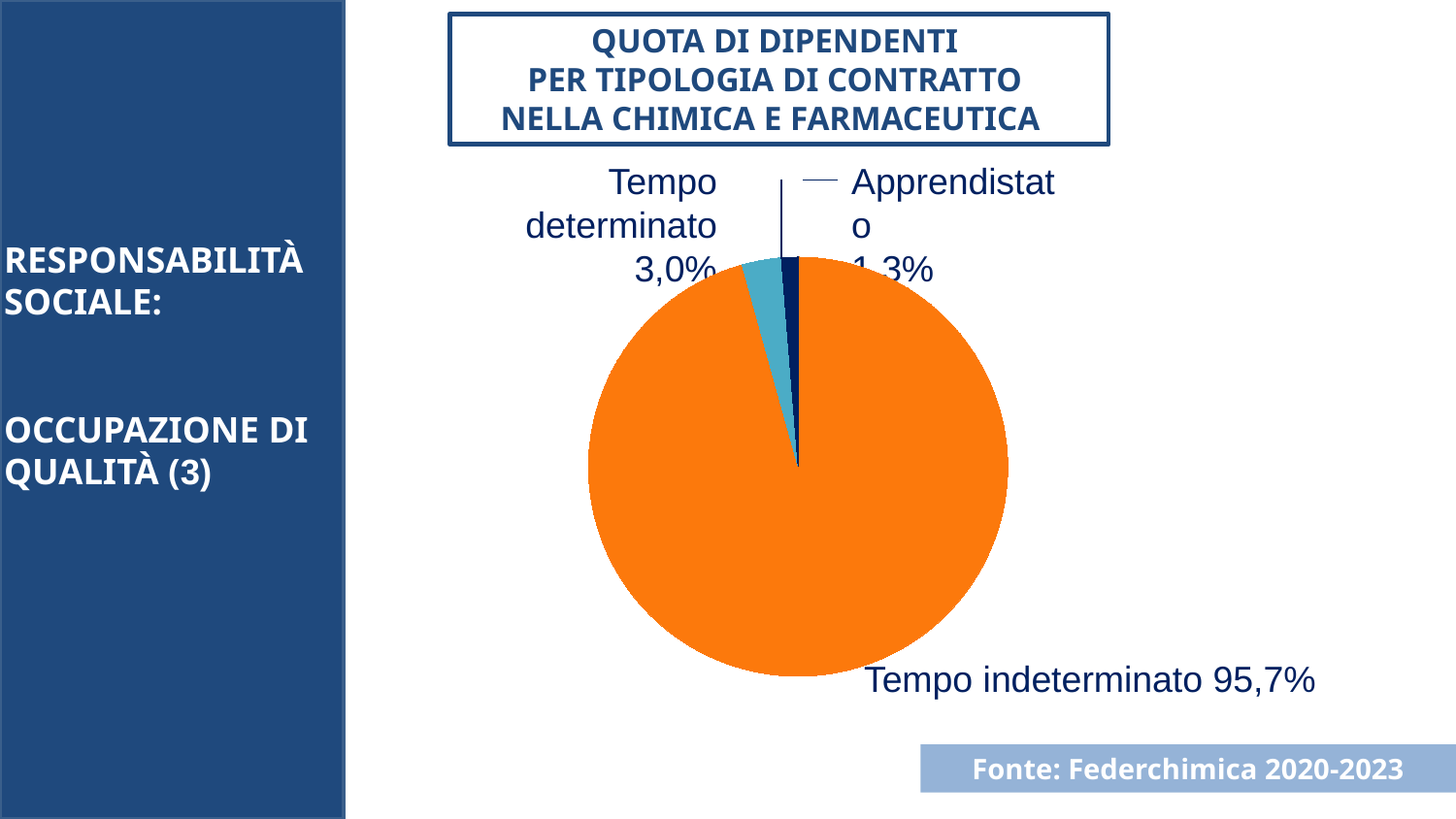
What share of employees have a 'Tempo determinato' contract? 3,0% What kind of chart is shown on the slide? Pie chart What is the difference in percentage points between the 'Tempo determinato' and 'Apprendistato' shares? 1,7 What share of employees have an 'Apprendistato' contract? 1,3% Which contract type has the largest share of employees? Tempo indeterminato How many contract types are shown in the pie chart? 3 Which is larger, the share for 'Tempo determinato' or for 'Apprendistato'? Tempo determinato What is the source cited for the chart data? Federchimica 2020-2023 What is the title of the chart? QUOTA DI DIPENDENTI PER TIPOLOGIA DI CONTRATTO NELLA CHIMICA E FARMACEUTICA What share of employees have a 'Tempo indeterminato' contract? 95,7% Which contract type has the smallest share of employees? Apprendistato What is the combined share of 'Tempo determinato' and 'Apprendistato' contracts? 4,3%